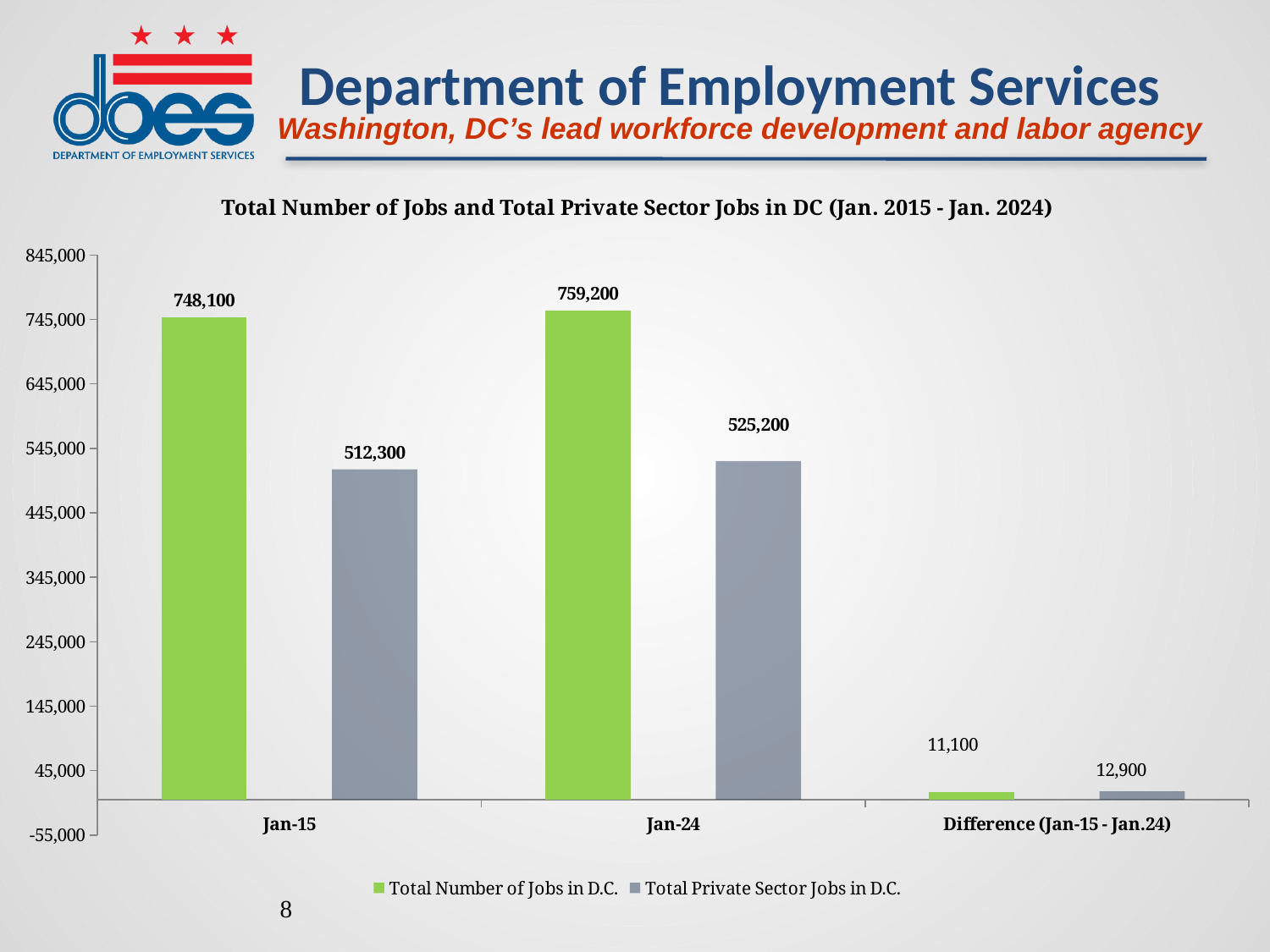
What is the Total Number of Jobs in D.C. for Jan-15? 748,100 What kind of chart is shown on the slide? Bar chart How many series does the legend list? 2 How many categories are shown on the x axis? 3 What is the Total Private Sector Jobs in D.C. value for Jan-15? 512,300 Which category has the highest Total Number of Jobs in D.C.? Jan-24 Which category has the lowest Total Private Sector Jobs in D.C.? Difference (Jan-15 - Jan.24) What is the difference between the Total Number of Jobs in D.C. and the Total Private Sector Jobs in D.C. for Jan-24? 234,000 Is the Total Number of Jobs in D.C. for Jan-15 greater or less than 745,000? greater What is the Total Private Sector Jobs in D.C. value for Jan-24? 525,200 Which is larger: the Total Private Sector Jobs in D.C. for Jan-15 or for Jan-24? Jan-24 What is the Total Number of Jobs in D.C. value shown for Difference (Jan-15 - Jan.24)? 11,100